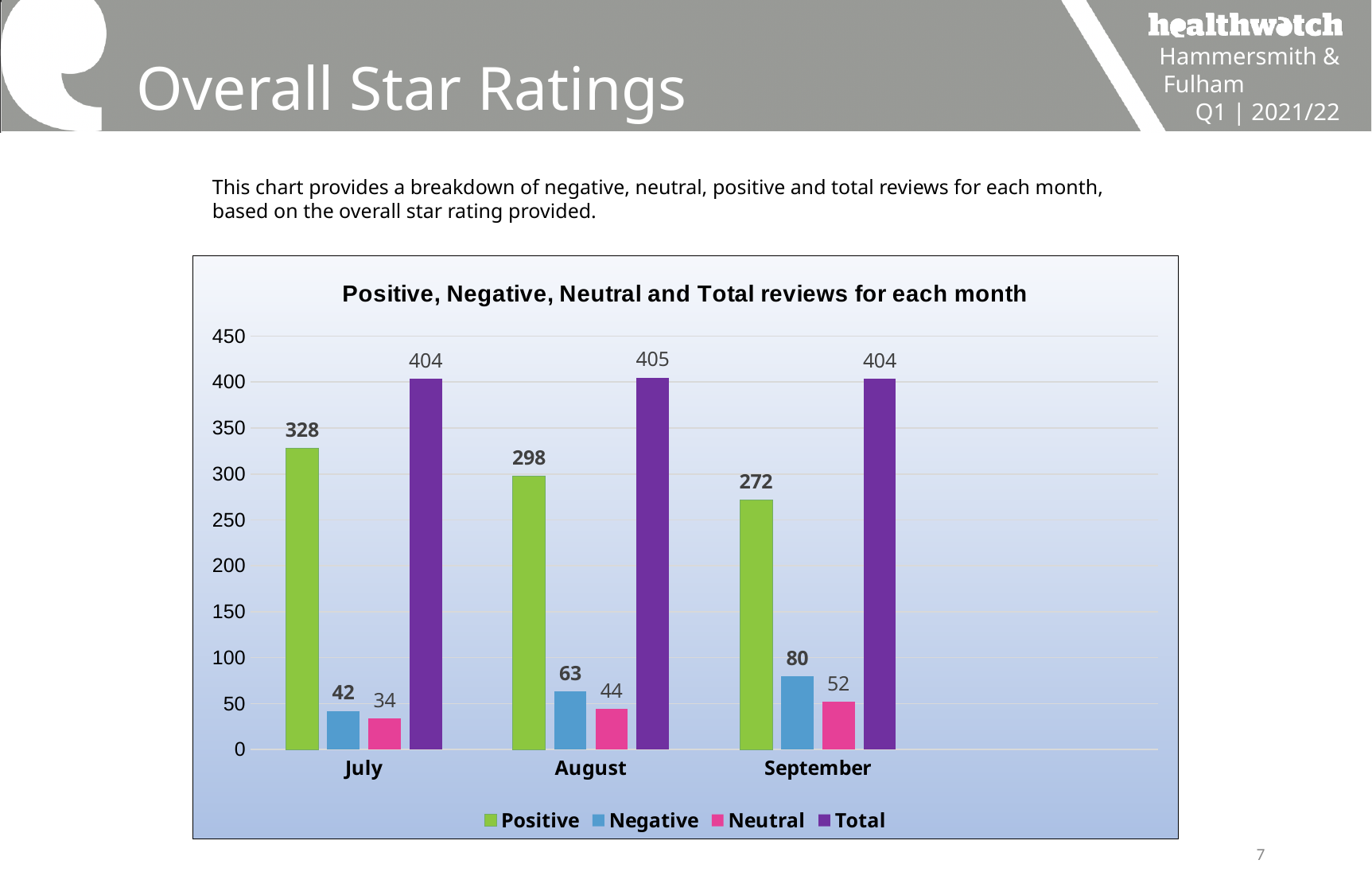
Do Positive reviews rise or fall from July to September? Fall How many months are shown on the x axis? 3 What is the Total number of reviews in August? 405 What is the number of Negative reviews in September? 80 What is the number of Positive reviews in July? 328 What kind of chart is shown? Bar chart Which month has the lowest number of Negative reviews? July What is the difference between Positive reviews in July and September? 56 How many series does the legend list? 4 What is the number of Neutral reviews in August? 44 Which month has the highest number of Positive reviews? July Which is larger: Neutral reviews in September or Negative reviews in August? Negative reviews in August